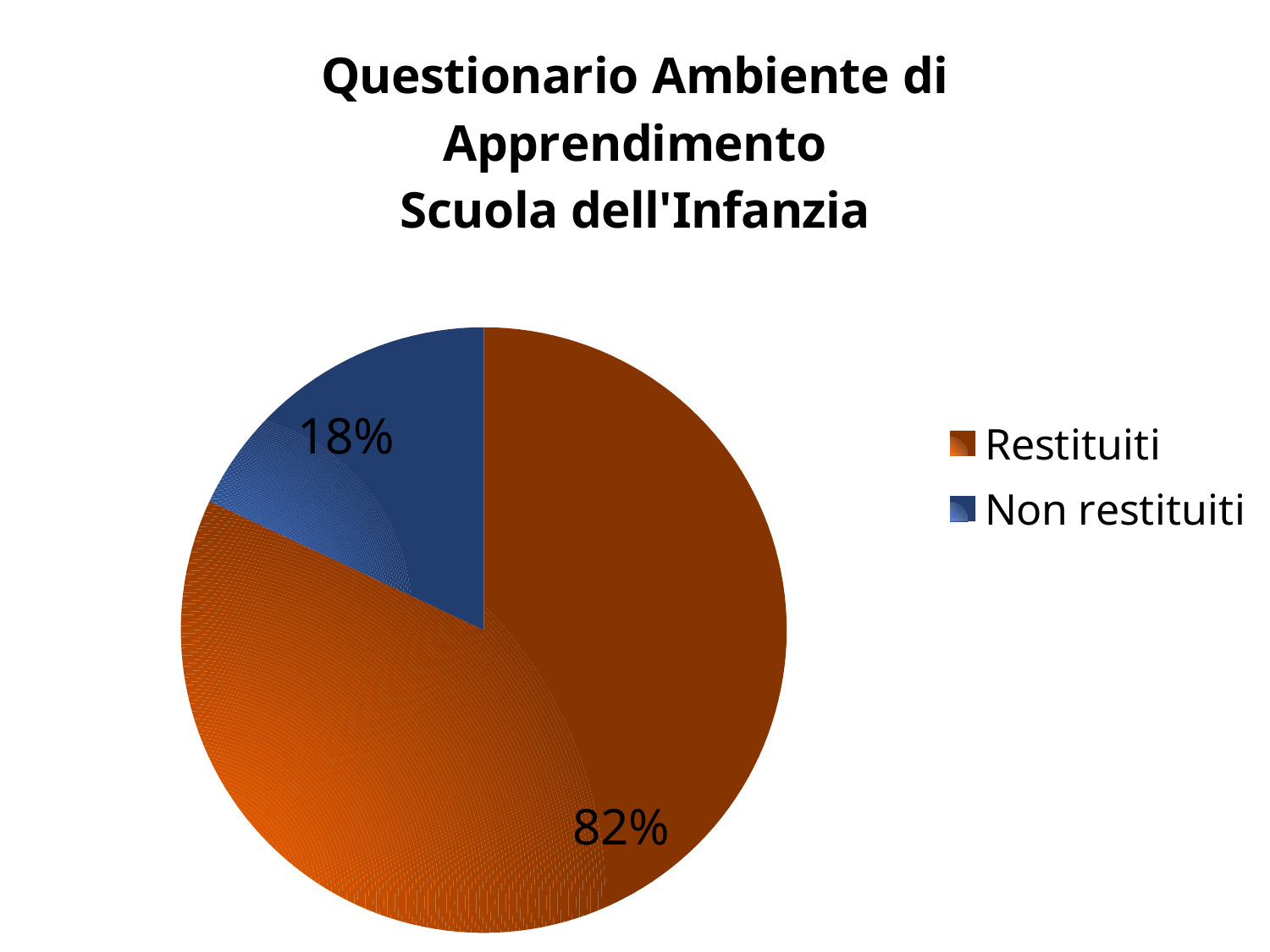
What share of the pie does the Restituiti slice represent? 82% Which slice is the smallest in the pie chart? Non restituiti Which slice is the largest in the pie chart? Restituiti What colour is the Non restituiti slice? Blue Which is larger, the Restituiti slice or the Non restituiti slice? Restituiti What is the title of the chart? Questionario Ambiente di Apprendimento Scuola dell'Infanzia How many slices does the pie chart have? 2 What share of the pie does the Non restituiti slice represent? 18% What is the difference in percentage points between the Restituiti and Non restituiti slices? 64 What kind of chart is shown on the slide? Pie chart How many entries does the legend list? 2